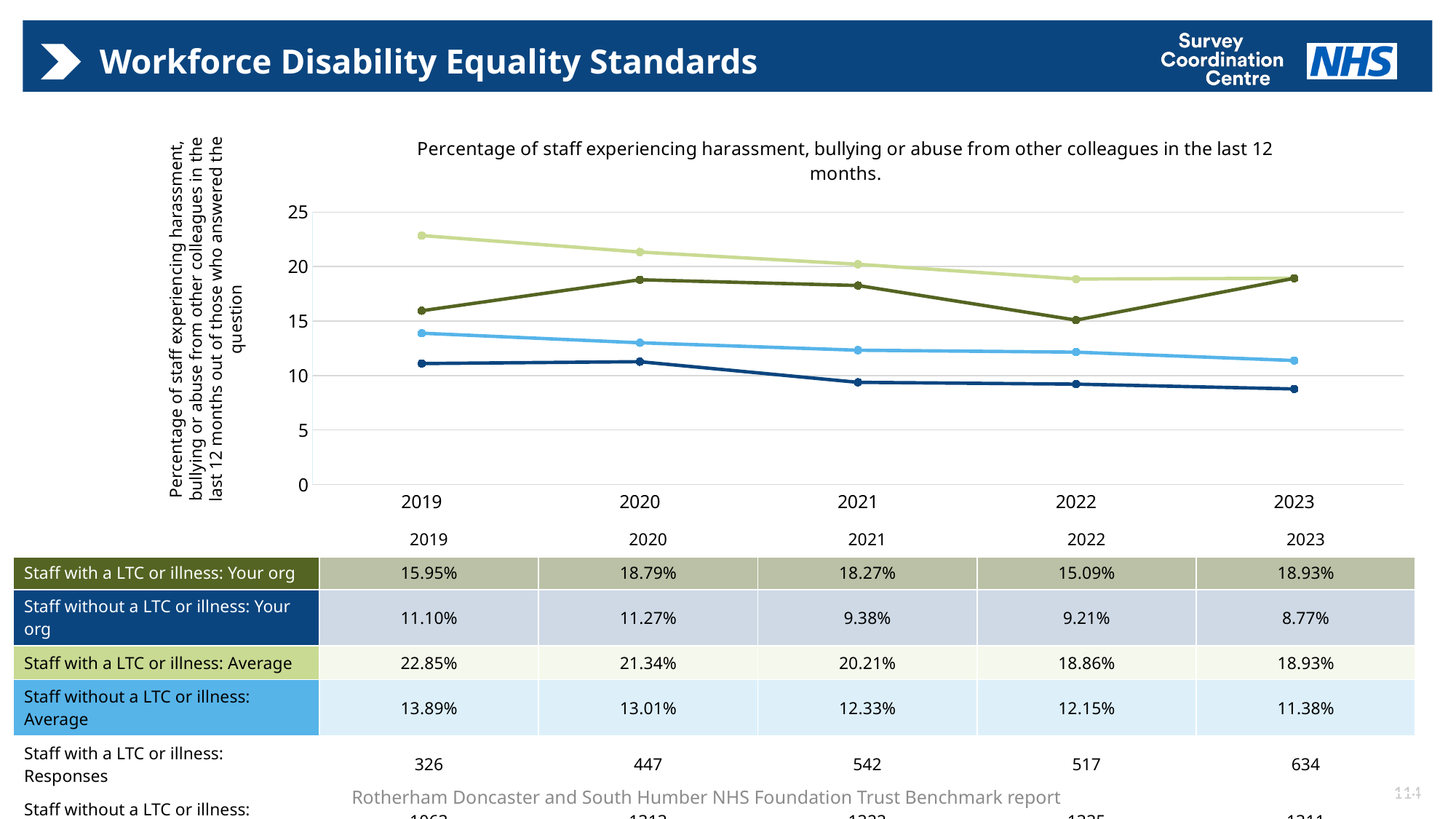
In which year is the value for Staff with a LTC or illness: Your org lowest? 2022 How many series are plotted on the chart? 4 In which year is the value for Staff with a LTC or illness: Average highest? 2019 Which is larger in 2022: Staff with a LTC or illness: Your org or Staff with a LTC or illness: Average? Staff with a LTC or illness: Average What type of chart is shown on the slide? line chart What is the title of the chart? Percentage of staff experiencing harassment, bullying or abuse from other colleagues in the last 12 months. What is the value for Staff without a LTC or illness: Average in 2023? 11.38% How many years are plotted on the x axis? 5 Does the value for Staff without a LTC or illness: Your org rise or fall from 2020 to 2023? fall What is the value for Staff with a LTC or illness: Your org in 2020? 18.79% What is the difference between Staff with a LTC or illness: Your org and Staff without a LTC or illness: Your org in 2023? 10.16% What is the value for Staff with a LTC or illness: Average in 2019? 22.85%